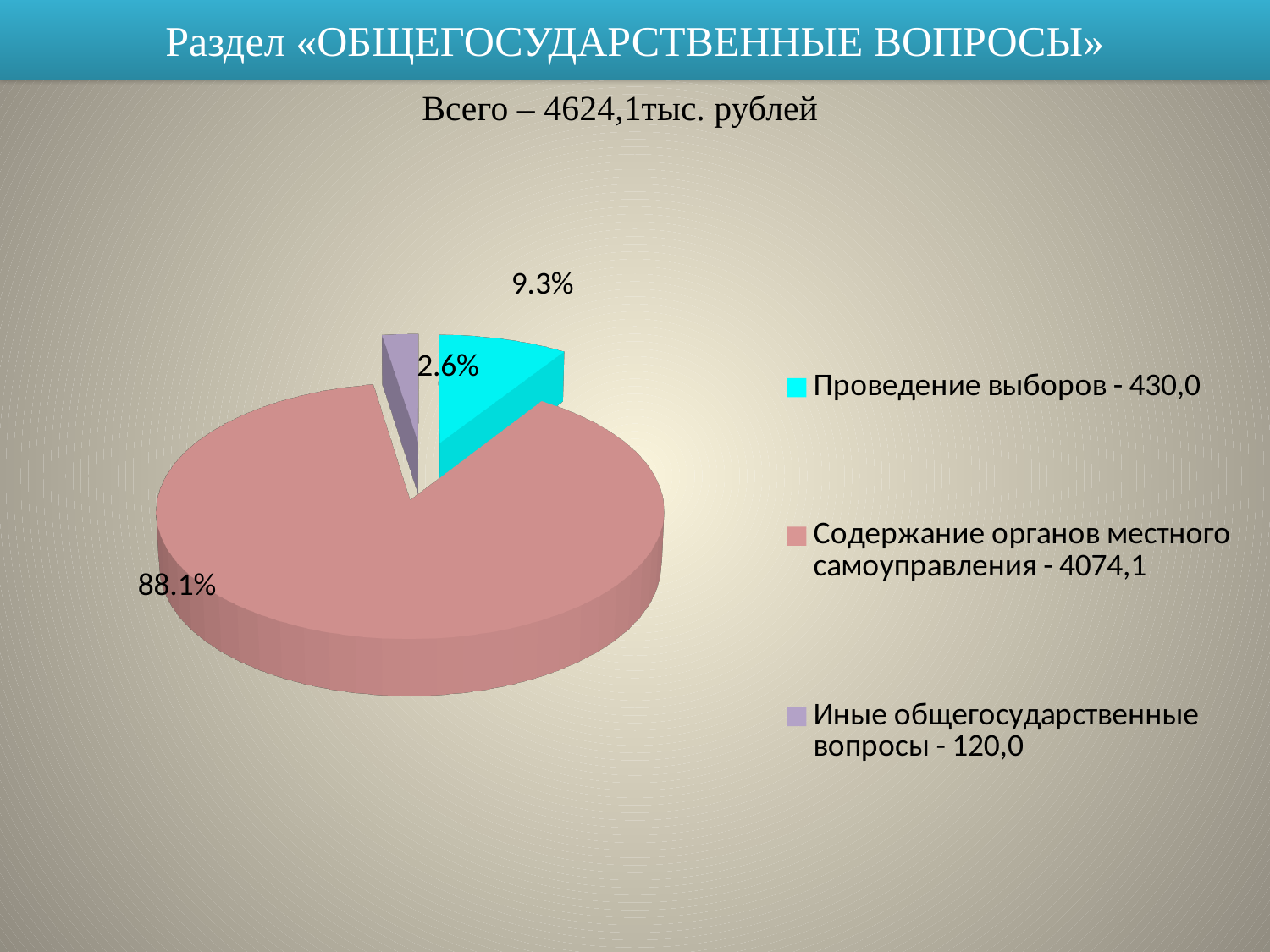
What percentage share does the slice for Иные общегосударственные вопросы have? 2.6% Which is larger: the share for Проведение выборов or the share for Иные общегосударственные вопросы? Проведение выборов What percentage share does the slice for Содержание органов местного самоуправления have? 88.1% How many slices does the pie chart have? 3 Which category has the largest slice of the pie? Содержание органов местного самоуправления What total amount is stated above the chart? 4624,1 тыс. рублей What value is given in the legend for Проведение выборов? 430,0 Which category has the smallest slice of the pie? Иные общегосударственные вопросы What percentage share does the slice for Проведение выборов have? 9.3% What kind of chart is shown on the slide? pie chart What value is given in the legend for Иные общегосударственные вопросы? 120,0 How many entries does the legend list? 3